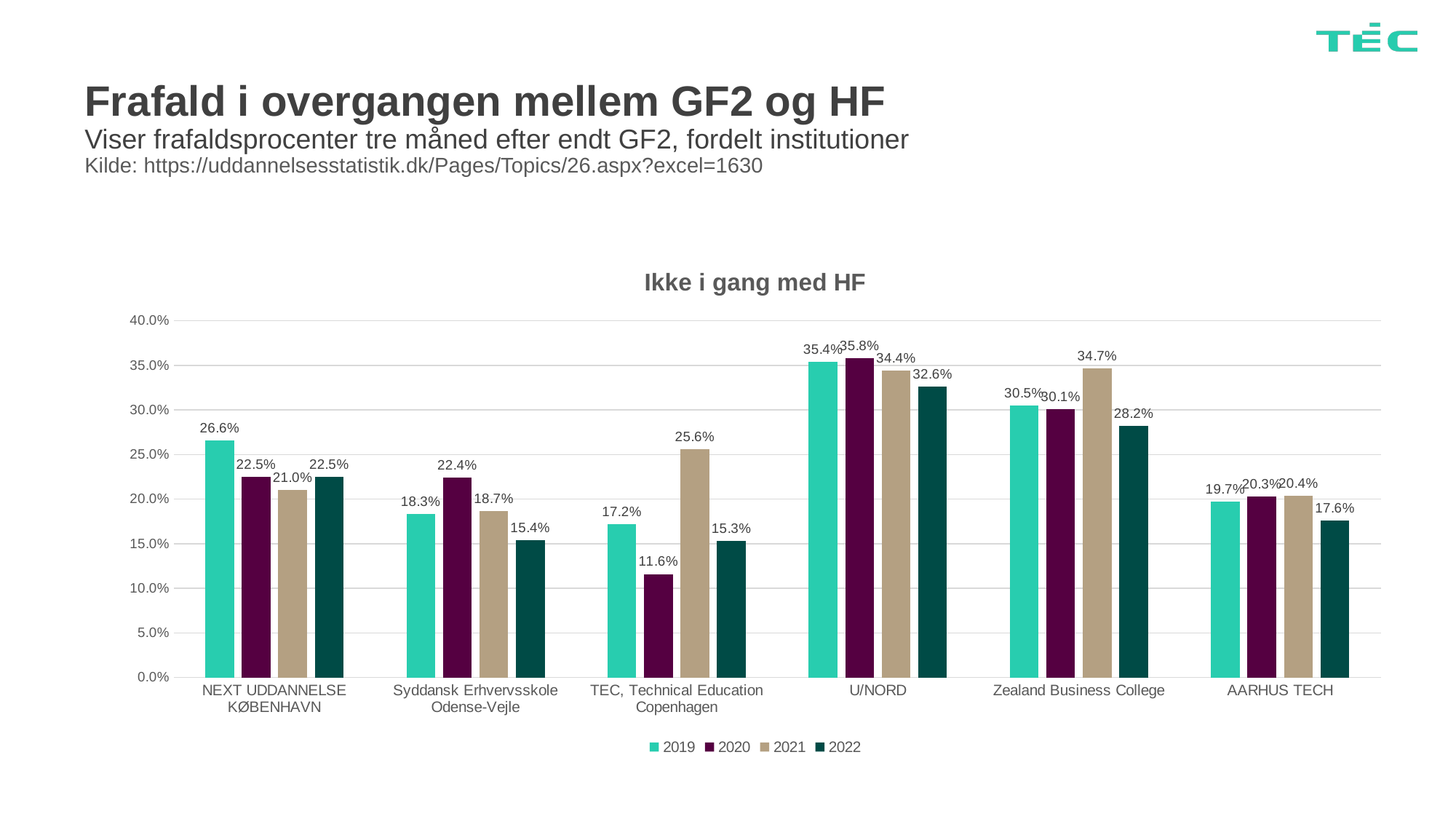
What is the value for U/NORD in 2020? 35.8% What is the title of the chart? Ikke i gang med HF Which is larger for Zealand Business College: the 2021 value or the 2022 value? 2021 What is the difference between the 2019 and 2022 values for NEXT UDDANNELSE KØBENHAVN? 4.1% How many series does the legend list? 4 How many institutions are shown on the x axis? 6 Which institution has the highest value in 2022? U/NORD What kind of chart is shown? Bar chart What is the value for TEC, Technical Education Copenhagen in 2021? 25.6% Which institution has the lowest value in 2020? TEC, Technical Education Copenhagen Do the values for Syddansk Erhvervsskole Odense-Vejle rise or fall from 2021 to 2022? Fall What is the value for AARHUS TECH in 2022? 17.6%